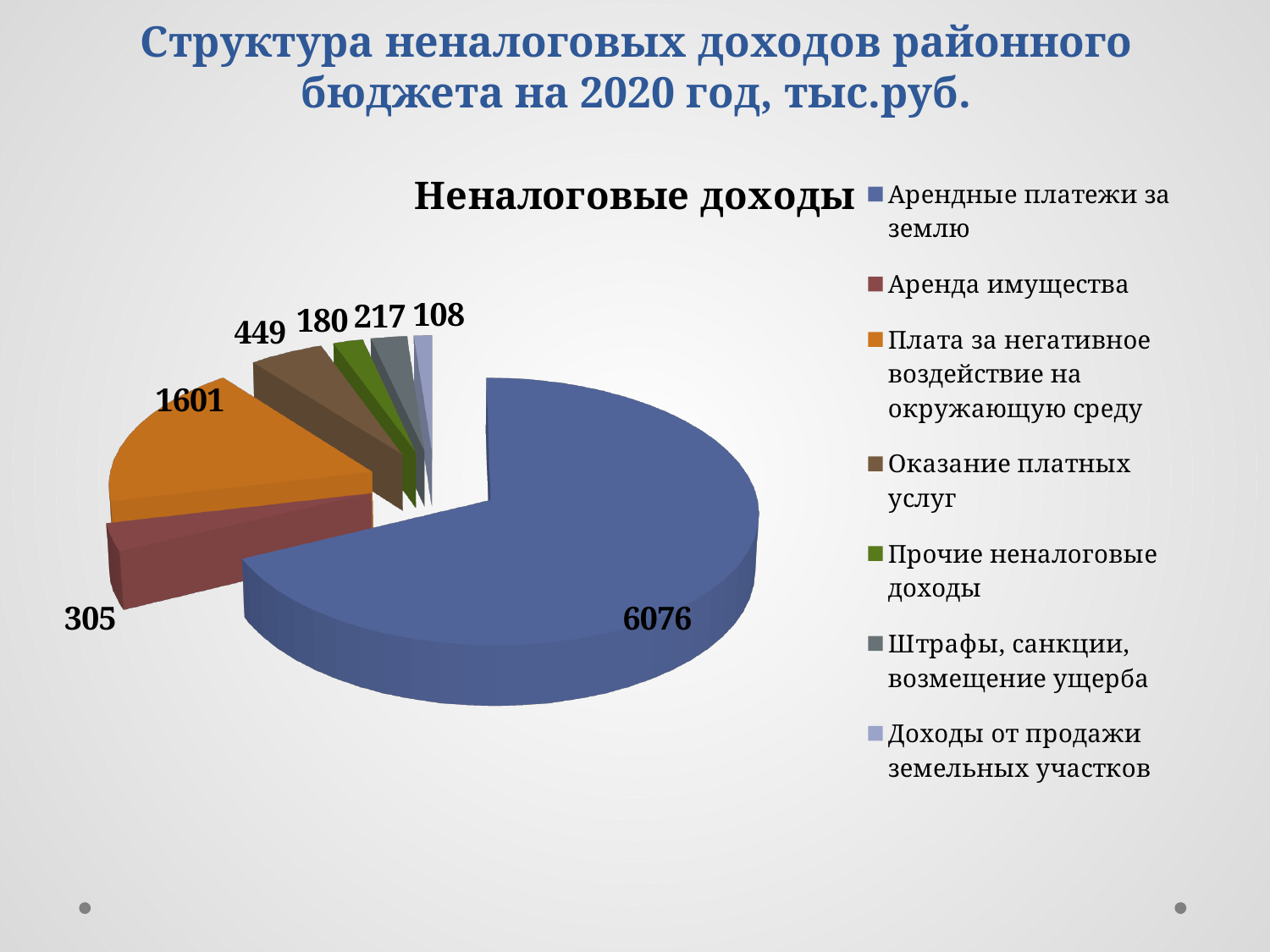
Which category has the largest slice of the pie? Арендные платежи за землю Which category has the smallest slice of the pie? Доходы от продажи земельных участков Which is larger, the value for Оказание платных услуг or the value for Аренда имущества? Оказание платных услуг What is the value for Плата за негативное воздействие на окружающую среду? 1601 What is the title of the chart? Неналоговые доходы What is the difference between the values for Арендные платежи за землю and Плата за негативное воздействие на окружающую среду? 4475 What share of the pie does Арендные платежи за землю represent, to the nearest whole percent? 68% What is the value for Арендные платежи за землю? 6076 How many categories does the pie chart have? 7 What kind of chart is shown on the slide? Pie chart What is the value for Штрафы, санкции, возмещение ущерба? 217 What is the value for Аренда имущества? 305